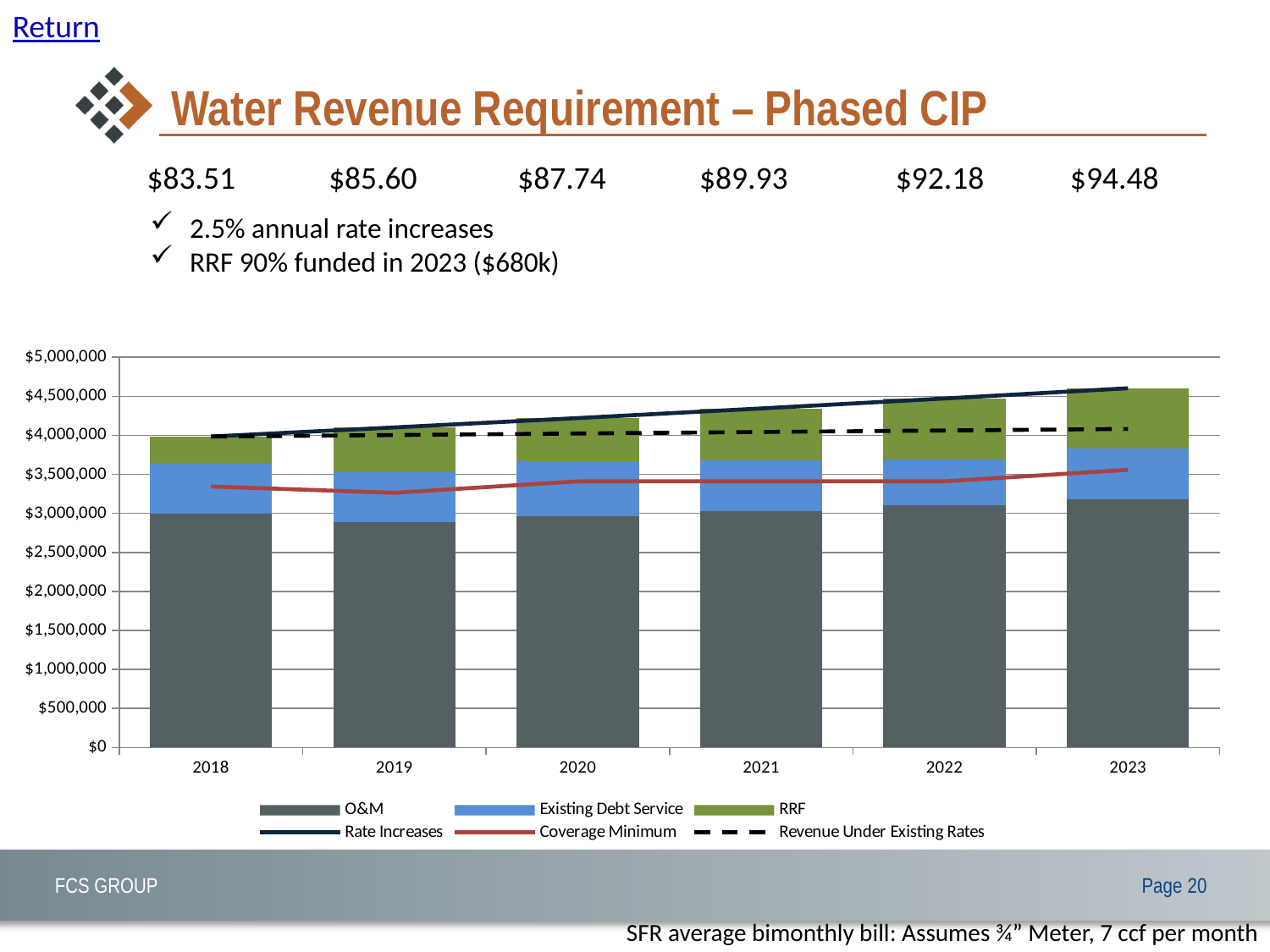
Which year has the tallest stacked bar? 2023 Is the total of the stacked bar for 2021 greater or less than $4,500,000? less What kind of chart is shown on the slide? Stacked bar chart with line series Is the RRF segment larger in 2023 or in 2018? 2023 Is the total of the stacked bar for 2023 greater or less than $4,500,000? greater Do the total stacked bar heights rise or fall from 2018 to 2023? Rise Which year has the shortest stacked bar? 2018 How many series does the chart legend list? 6 Which legend entry is drawn as a dashed line? Revenue Under Existing Rates Is the Coverage Minimum value for 2019 greater or less than $3,500,000? less How many years are shown on the x axis of the chart? 6